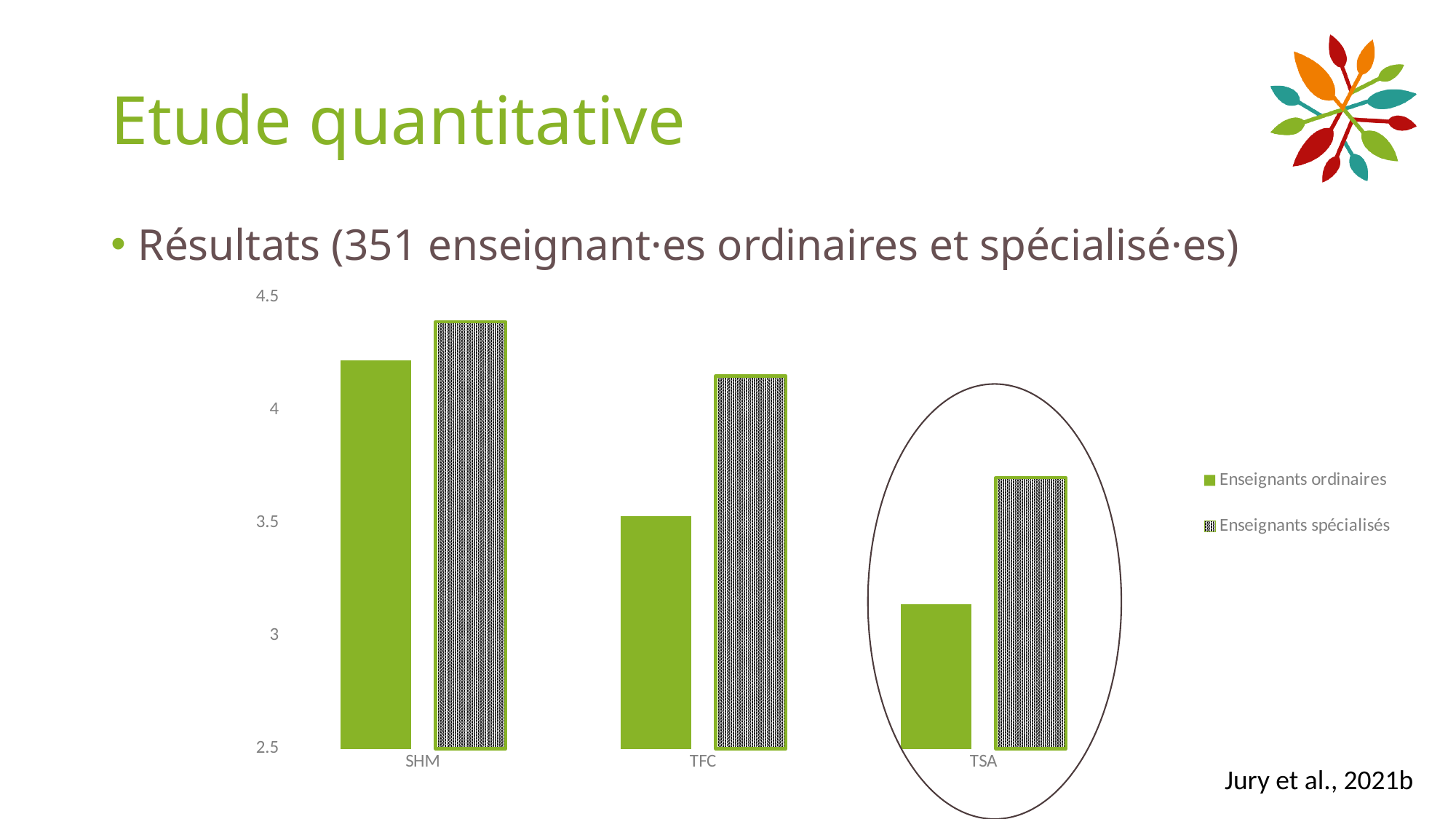
Which category has the highest value for Enseignants ordinaires? SHM How many categories are shown on the x axis of the chart? 3 Which category on the chart is circled? TSA What kind of chart is shown on the slide? bar chart Is the value for Enseignants ordinaires at TSA greater or less than 3.5? less Which category has the lowest value for Enseignants ordinaires? TSA For TSA, which series has the larger value: Enseignants ordinaires or Enseignants spécialisés? Enseignants spécialisés Do the values for Enseignants ordinaires rise or fall from SHM to TSA along the x axis? fall Is the value for Enseignants ordinaires at SHM greater or less than 4? greater How many series does the chart's legend list? 2 Is the value for Enseignants spécialisés at TFC greater or less than 4? greater Which category has the lowest value for Enseignants spécialisés? TSA